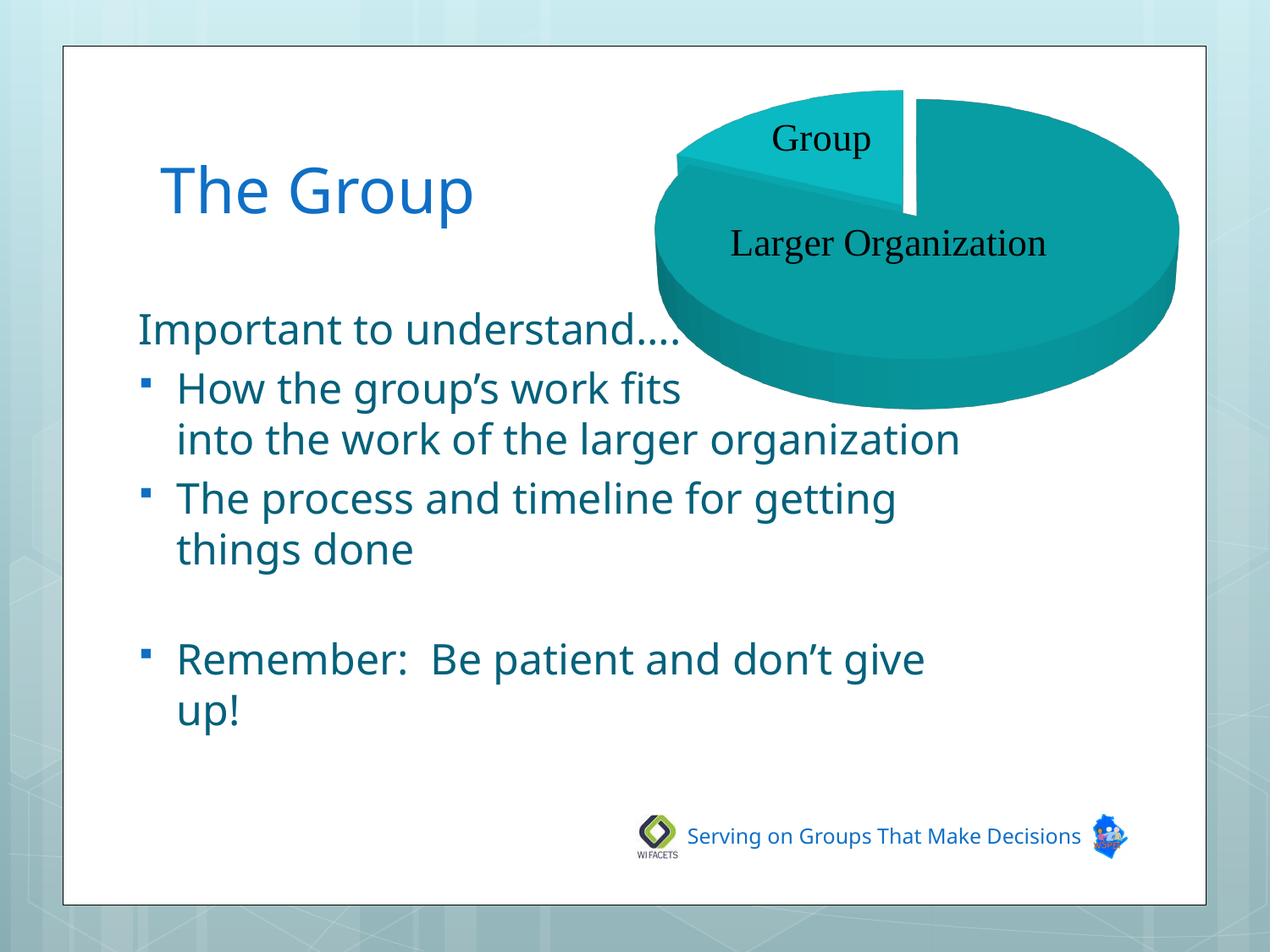
Which slice is larger in the pie chart, Group or Larger Organization? Larger Organization Is the pie chart drawn with a 3-D effect? yes What kind of chart is shown on the slide? pie chart Which slice of the pie chart is the largest? Larger Organization How many slices does the pie chart have? 2 Which slice of the pie chart is the smallest? Group What are the labels of the two slices in the pie chart? Group and Larger Organization